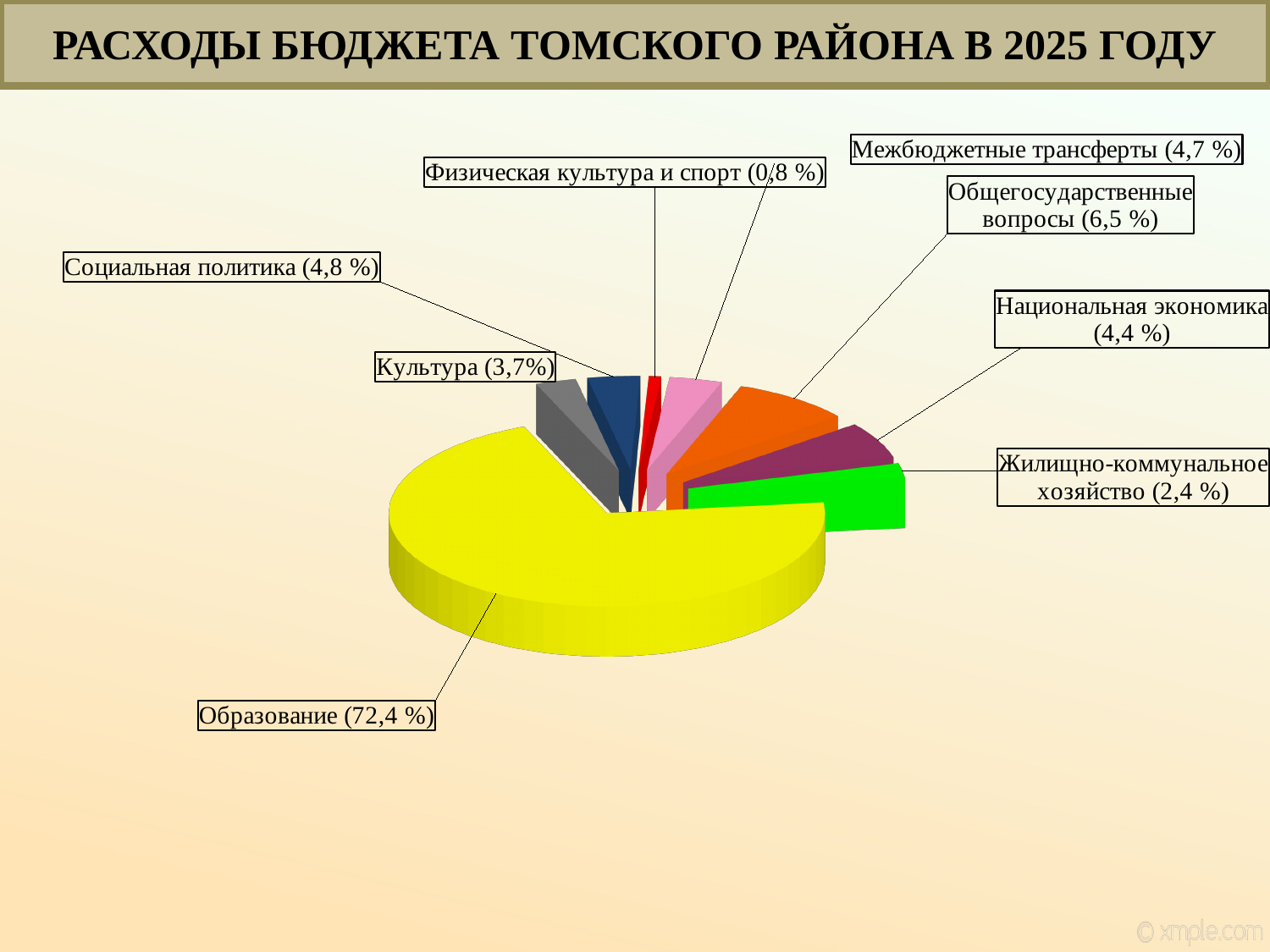
What share is shown for Общегосударственные вопросы? 6,5 % What type of chart is shown on the slide? pie chart What is the difference between the shares of Общегосударственные вопросы and Межбюджетные трансферты? 1,8 % Which category has the smallest share of the pie? Физическая культура и спорт What is the difference between the shares of Социальная политика and Культура? 1,1 % Which category has the largest share of the pie? Образование How many categories (slices) does the pie chart have? 8 What share is shown for Физическая культура и спорт? 0,8 % What share is shown for Жилищно-коммунальное хозяйство? 2,4 % Which is larger: the share for Социальная политика or the share for Национальная экономика? Социальная политика What share of the budget expenditures goes to Образование? 72,4 % What is the title of the slide containing the chart? РАСХОДЫ БЮДЖЕТА ТОМСКОГО РАЙОНА В 2025 ГОДУ